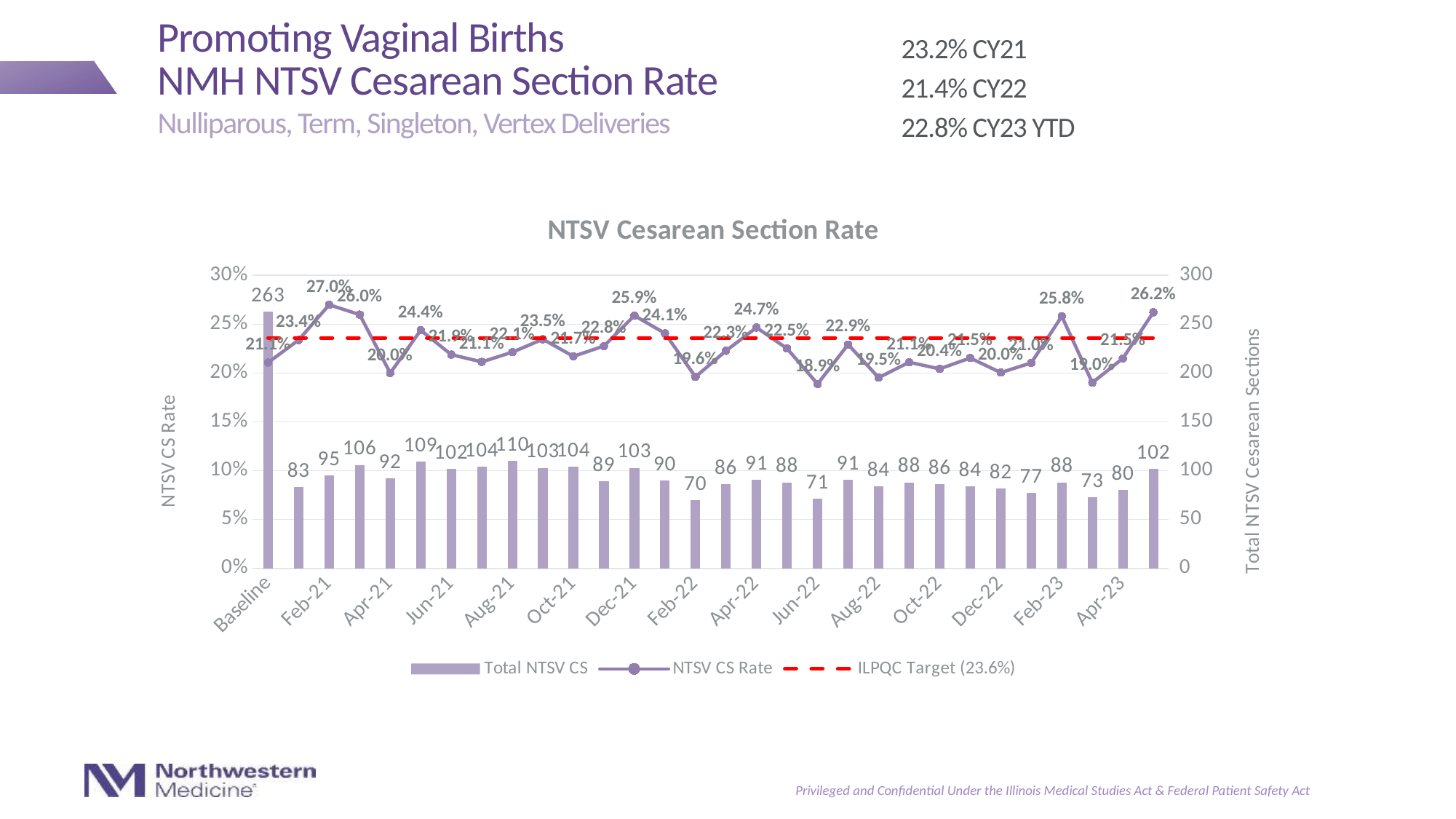
How many series does the legend list? 3 Which period has the highest Total NTSV CS bar? Baseline What is the NTSV CS Rate for Dec-21? 25.9% What is the Total NTSV CS value for Feb-22? 70 Is the NTSV CS Rate for Feb-22 greater or less than 20%? less What is the Total NTSV CS value for the Baseline bar? 263 Which period has the highest NTSV CS Rate? Feb-21 What is the difference between the Baseline Total NTSV CS (263) and the Feb-22 Total NTSV CS (70)? 193 What value is the ILPQC Target shown in the legend? 23.6% What is the NTSV CS Rate for Feb-21? 27.0% Which has a larger Total NTSV CS value, Aug-21 or Feb-22? Aug-21 What is the Total NTSV CS value for Apr-23? 80